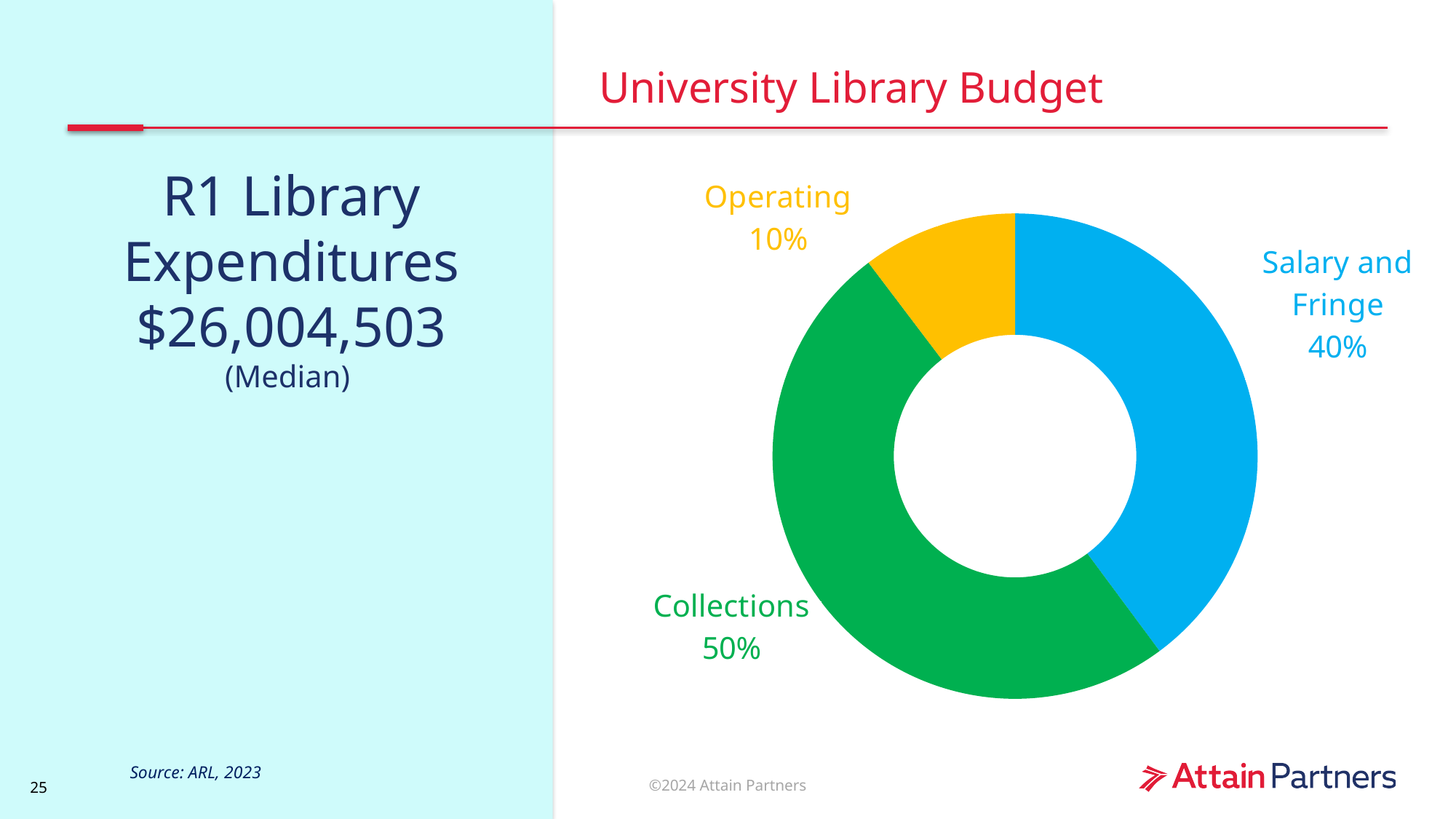
What colour is the Collections segment of the chart? Green What share of the university library budget goes to Collections? 50% What is the difference in percentage points between the Collections share and the Salary and Fringe share? 10 percentage points Which category has the largest share of the library budget? Collections What is the difference in percentage points between the Salary and Fringe share and the Operating share? 30 percentage points What kind of chart is shown on the slide? Doughnut (pie) chart Which category has the smallest share of the library budget? Operating Which is larger, the share for Salary and Fringe or the share for Operating? Salary and Fringe What is the title of the slide containing the chart? University Library Budget How many categories are shown in the chart? 3 What share of the university library budget goes to Operating? 10% What share of the university library budget goes to Salary and Fringe? 40%